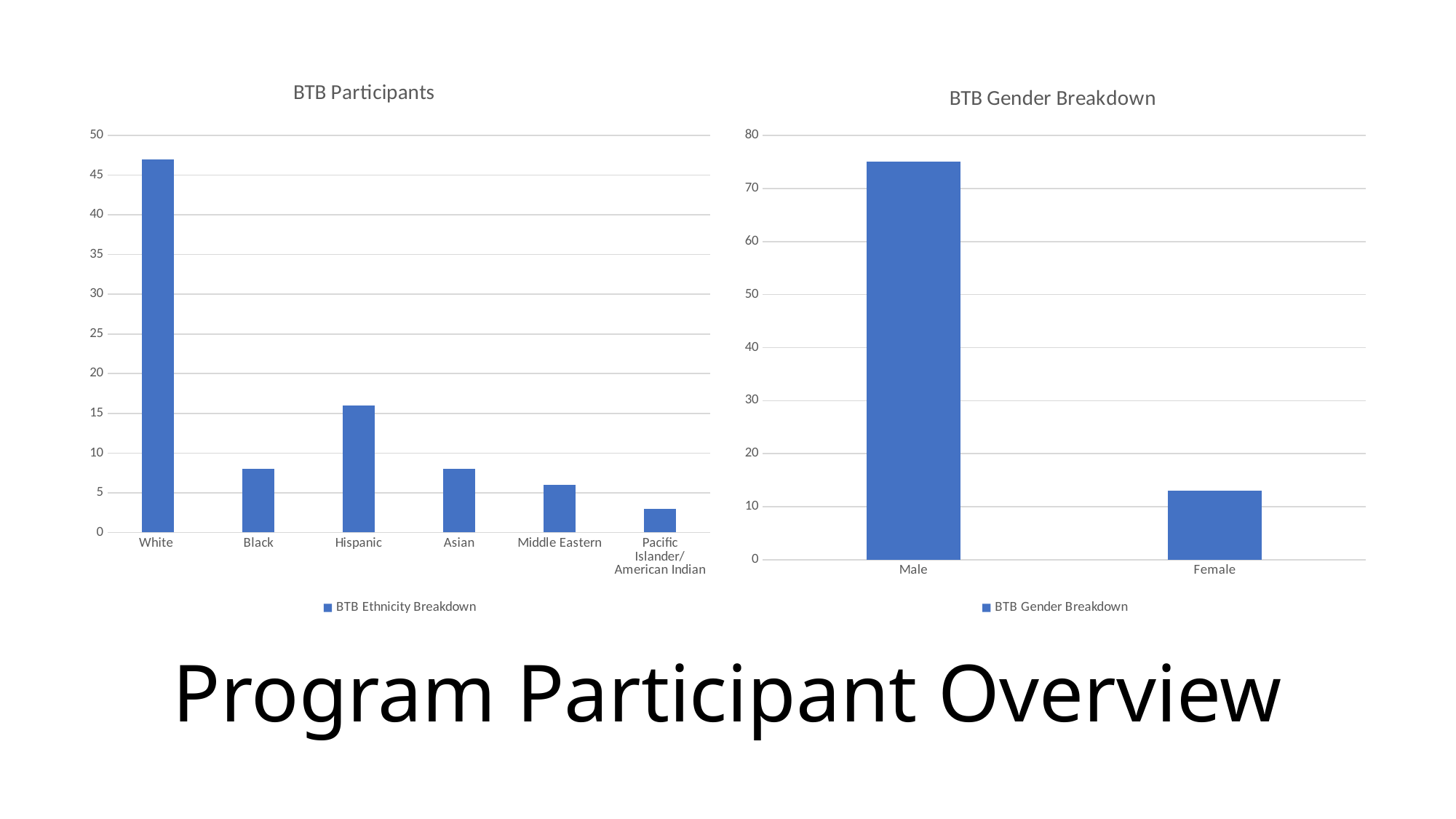
What is the legend entry shown under the BTB Participants chart? BTB Ethnicity Breakdown How many categories are shown in the BTB Participants chart? 6 In the BTB Participants chart, is the value for White greater or less than 45? greater In the BTB Gender Breakdown chart, is the value for Female greater or less than 20? less In the BTB Participants chart, which is larger, the value for Hispanic or the value for Black? Hispanic In the BTB Participants chart, is the value for Hispanic greater or less than 20? less In the BTB Participants chart, which category has the highest value? White What kind of chart is the BTB Gender Breakdown chart? bar chart In the BTB Participants chart, which category has the lowest value? Pacific Islander/American Indian In the BTB Gender Breakdown chart, which category has the highest value? Male